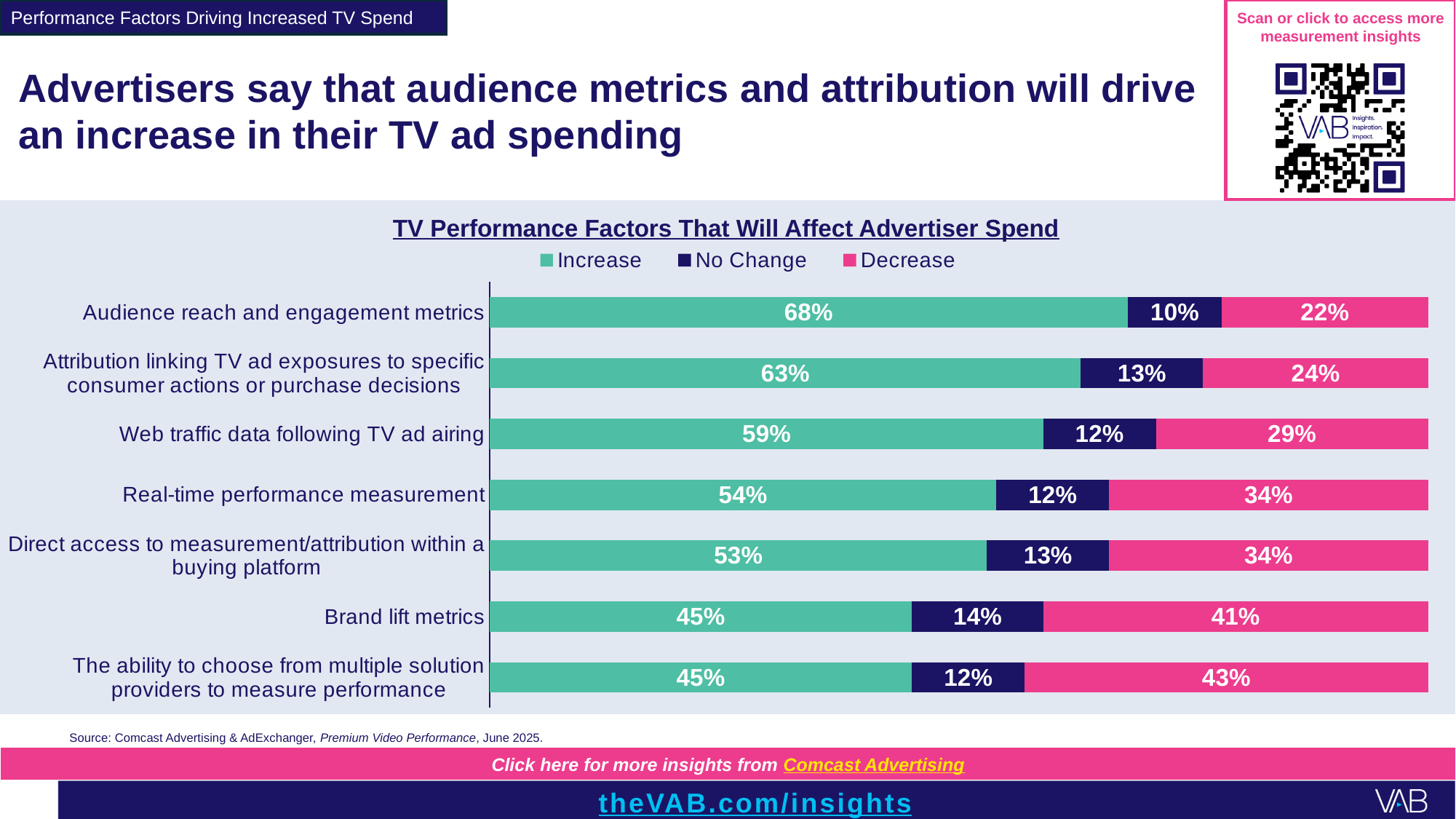
What is the title of the chart? TV Performance Factors That Will Affect Advertiser Spend What type of chart is shown? Stacked bar chart How many series does the legend list? 3 What percentage of advertisers say audience reach and engagement metrics will increase their TV spend? 68% What is the Decrease value for brand lift metrics? 41% What is the difference between the Increase values for audience reach and engagement metrics and brand lift metrics? 23 percentage points Which factor has the highest Decrease percentage? The ability to choose from multiple solution providers to measure performance How many factors are shown in the chart? 7 Which factor has the lowest No Change percentage? Audience reach and engagement metrics Which is larger: the Decrease value for real-time performance measurement or for web traffic data following TV ad airing? Real-time performance measurement What is the No Change value for web traffic data following TV ad airing? 12% Which factor has the highest Increase percentage? Audience reach and engagement metrics